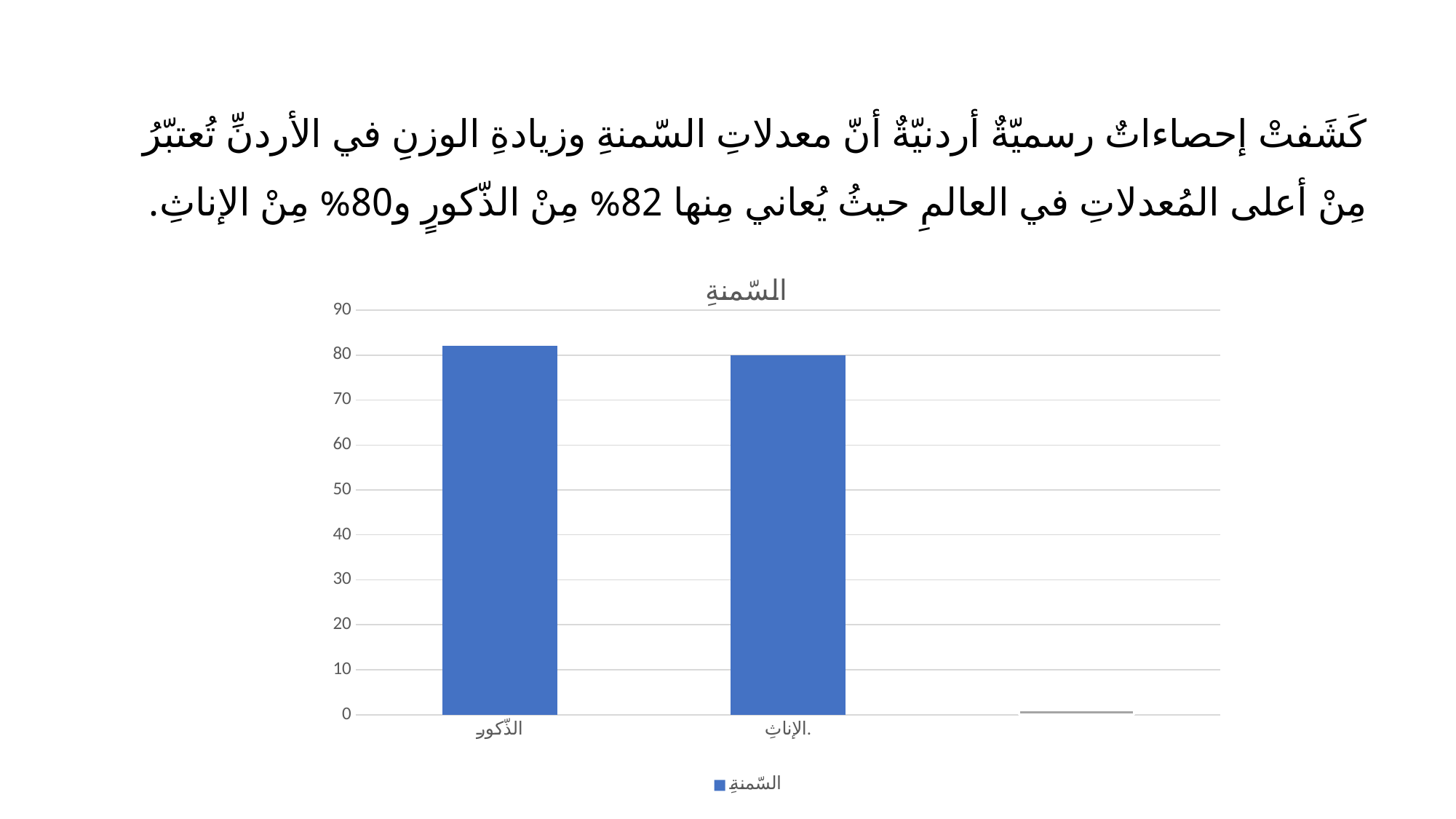
What colour are the bars in the chart? blue Which category has the highest value in the chart? الذّكورِ What is the difference between the values for الذّكورِ and الإناثِ? 2 Which category has the higher value, الذّكورِ or الإناثِ? الذّكورِ Is the value for الإناثِ greater or less than 90? less How many series does the legend list? 1 What kind of chart is shown on the slide? bar chart What is the value for الإناثِ in the chart? 80 What is the title of the chart? السّمنةِ What is the value for الذّكورِ in the chart? 82 Is the value for الذّكورِ greater or less than 50? greater